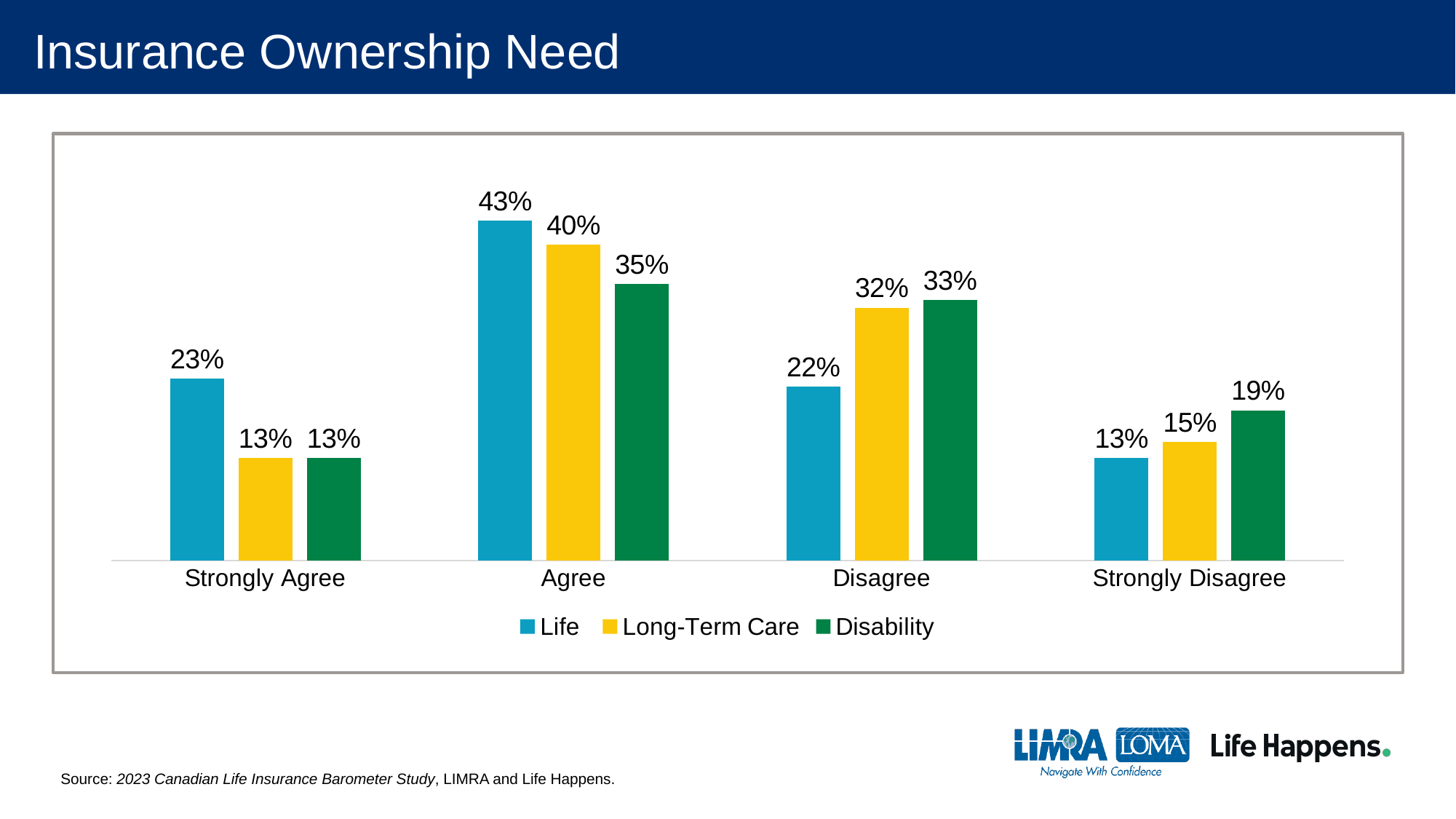
In the Disagree category, which is larger: Life or Disability? Disability What is the difference between the Life and Disability values in the Strongly Agree category? 10% What is the difference between the Long-Term Care values for Agree and Disagree? 8% Which series is shown in yellow in the legend? Long-Term Care Which category has the lowest value for Long-Term Care? Strongly Agree How many series does the legend list? 3 What is the value for Disability in the Strongly Disagree category? 19% What is the value for Long-Term Care in the Disagree category? 32% How many categories are shown on the x axis? 4 Which category has the highest value for Life? Agree What kind of chart is shown on the slide? Bar chart What is the value for Life in the Agree category? 43%